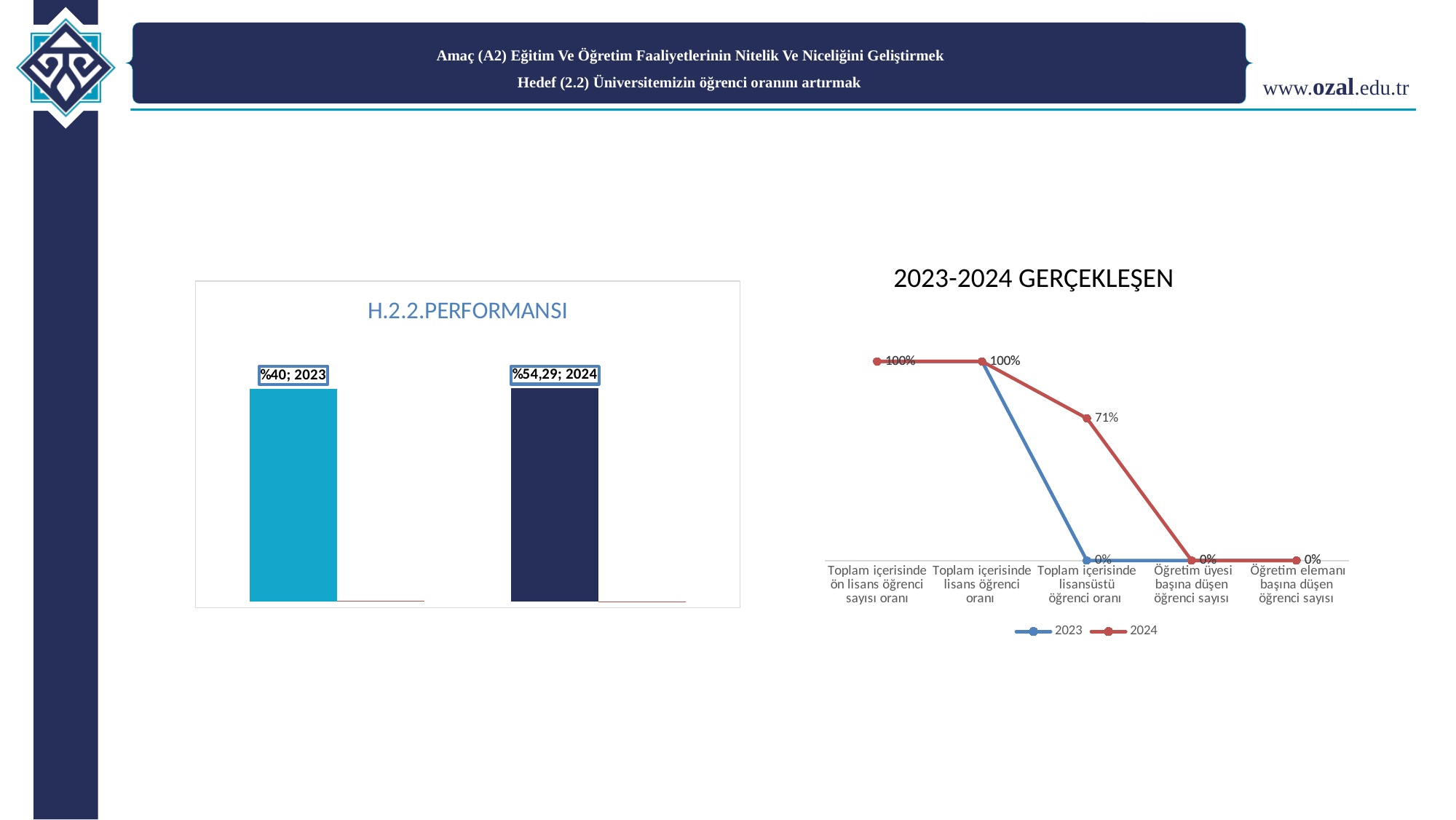
In the 2023-2024 GERÇEKLEŞEN chart, do the values rise or fall moving from left to right along the x axis? Fall In the 2023-2024 GERÇEKLEŞEN chart, which series is drawn in red? 2024 In the 2023-2024 GERÇEKLEŞEN chart, what is the 2023 value for 'Toplam içerisinde lisansüstü öğrenci oranı'? 0% How many series does the legend of the 2023-2024 GERÇEKLEŞEN chart list? 2 In the H.2.2.PERFORMANSI chart, how many bars are plotted? 2 How many categories are shown on the x axis of the 2023-2024 GERÇEKLEŞEN chart? 5 What kind of chart is the H.2.2.PERFORMANSI chart? Bar chart What kind of chart is the 2023-2024 GERÇEKLEŞEN chart? Line chart In the H.2.2.PERFORMANSI chart, what is the value for 2024? %54,29 In the H.2.2.PERFORMANSI chart, what is the value for 2023? %40 In the 2023-2024 GERÇEKLEŞEN chart, what is the 2024 value for 'Toplam içerisinde lisansüstü öğrenci oranı'? 71% In the H.2.2.PERFORMANSI chart, which year has the higher value? 2024